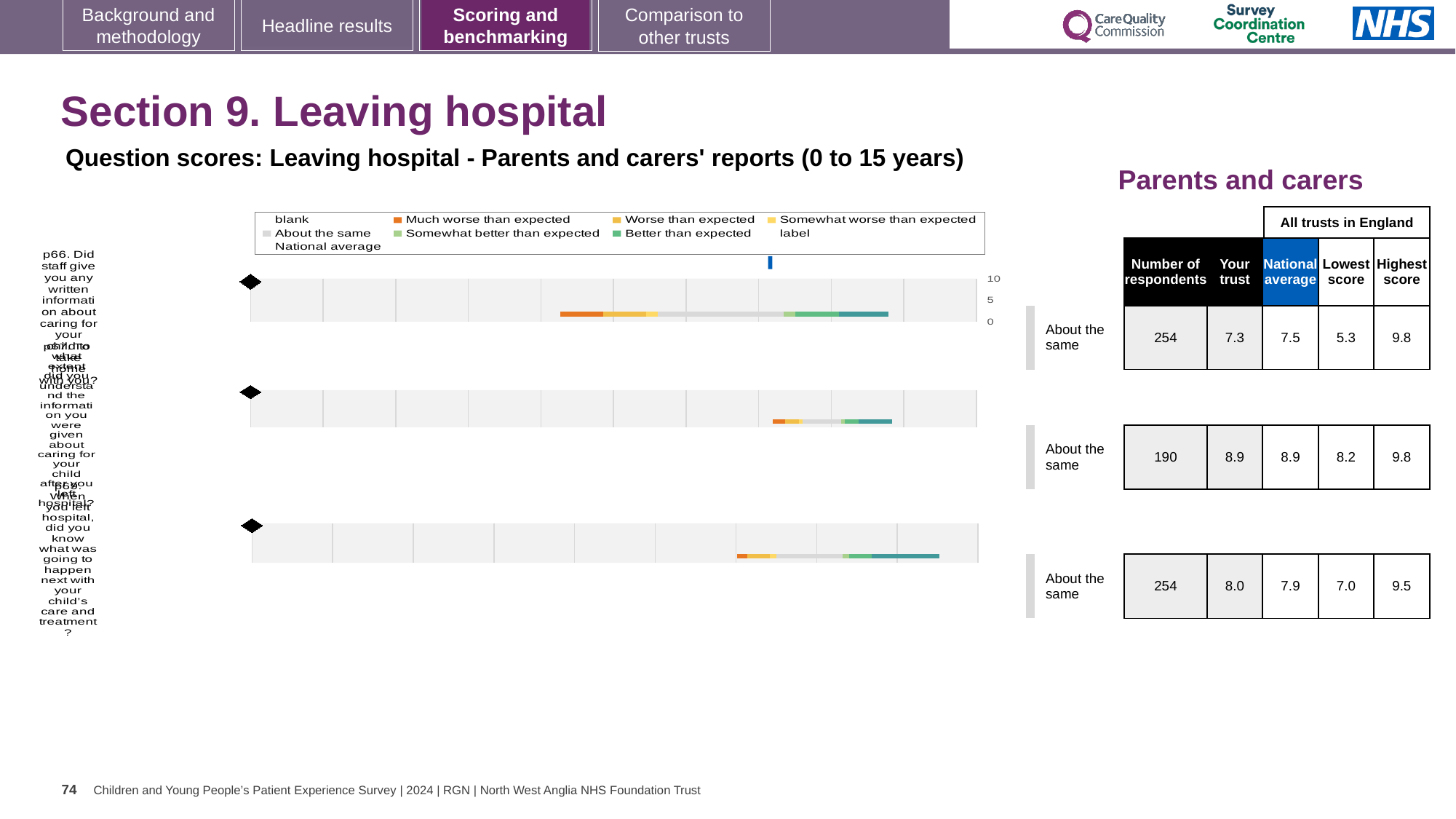
Which of the three questions has the lowest 'Lowest score' value in the table? the first question, p66 (5.3) In the chart legend, what colour represents 'Much worse than expected'? orange In the table beside the charts, what is the highest score for the third question (p68)? 9.5 For the third question (p68), what is the difference between the 'Your trust' score (8.0) and the national average (7.9)? 0.1 In the table beside the charts, what is the 'Your trust' score for the first question (p66)? 7.3 In the table beside the charts, how many respondents answered the second question? 190 In the table beside the charts, what is the national average for the first question (p66)? 7.5 Which of the three questions has the highest 'Your trust' score in the table? the second question (8.9) How many separate question-score charts are shown on the slide? 3 According to the legend, what does the blue vertical marker on the charts represent? National average For the third question (p68), which is larger: the 'Your trust' score or the national average? Your trust What kind of chart is used to show the question scores on this slide? bar chart